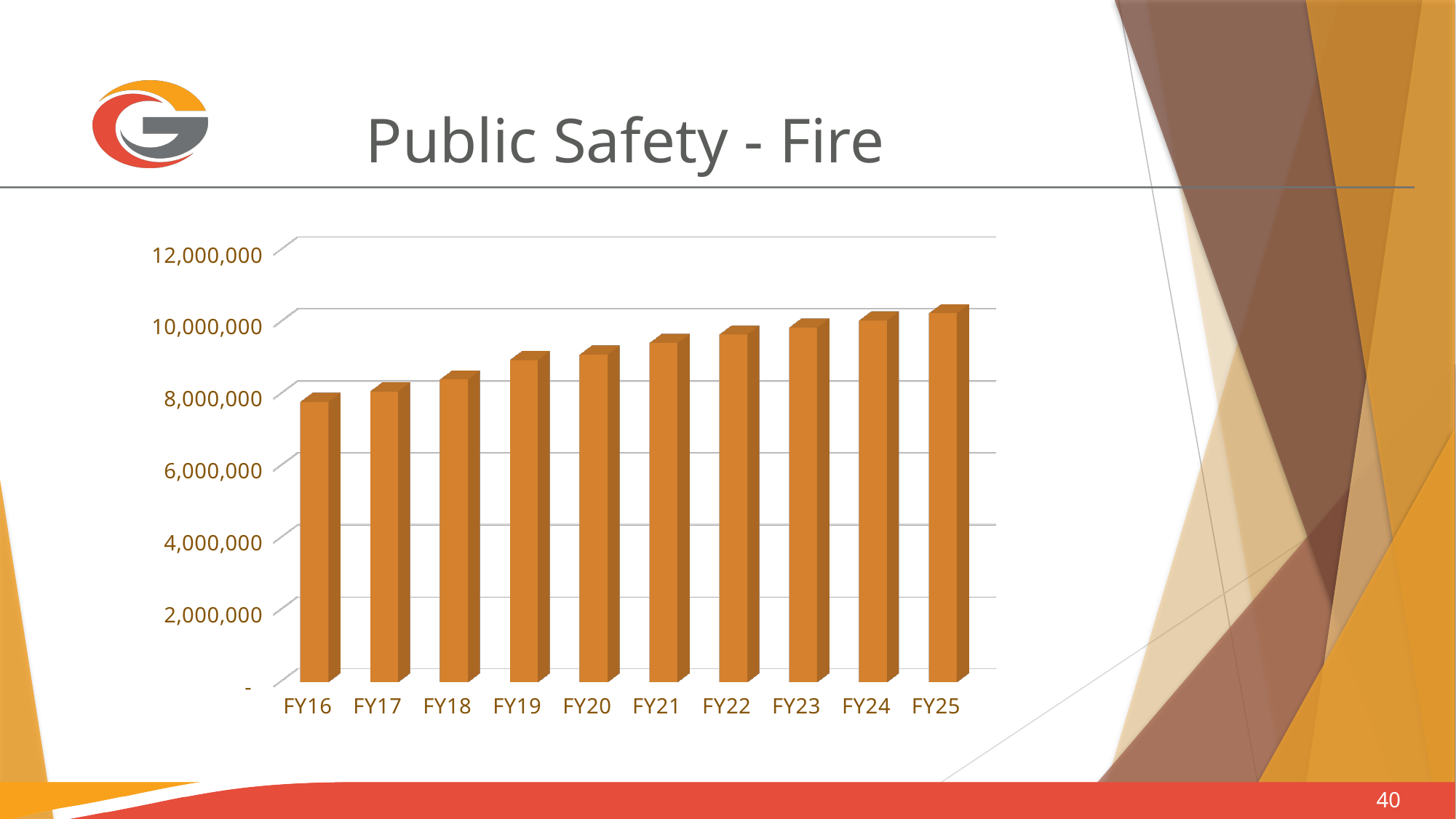
Do the values rise or fall from FY16 to FY25? Rise Which is larger, the value for FY17 or the value for FY22? FY22 What is the title of the slide containing the chart? Public Safety - Fire Which is larger, the value for FY25 or the value for FY16? FY25 Which fiscal year has the highest value on the chart? FY25 Is the value for FY25 greater or less than 12,000,000? less Is the value for FY21 greater or less than 8,000,000? greater What kind of chart is shown on the slide? Bar chart Is the value for FY16 greater or less than 10,000,000? less How many fiscal years are plotted on the chart? 10 Which fiscal year has the lowest value on the chart? FY16